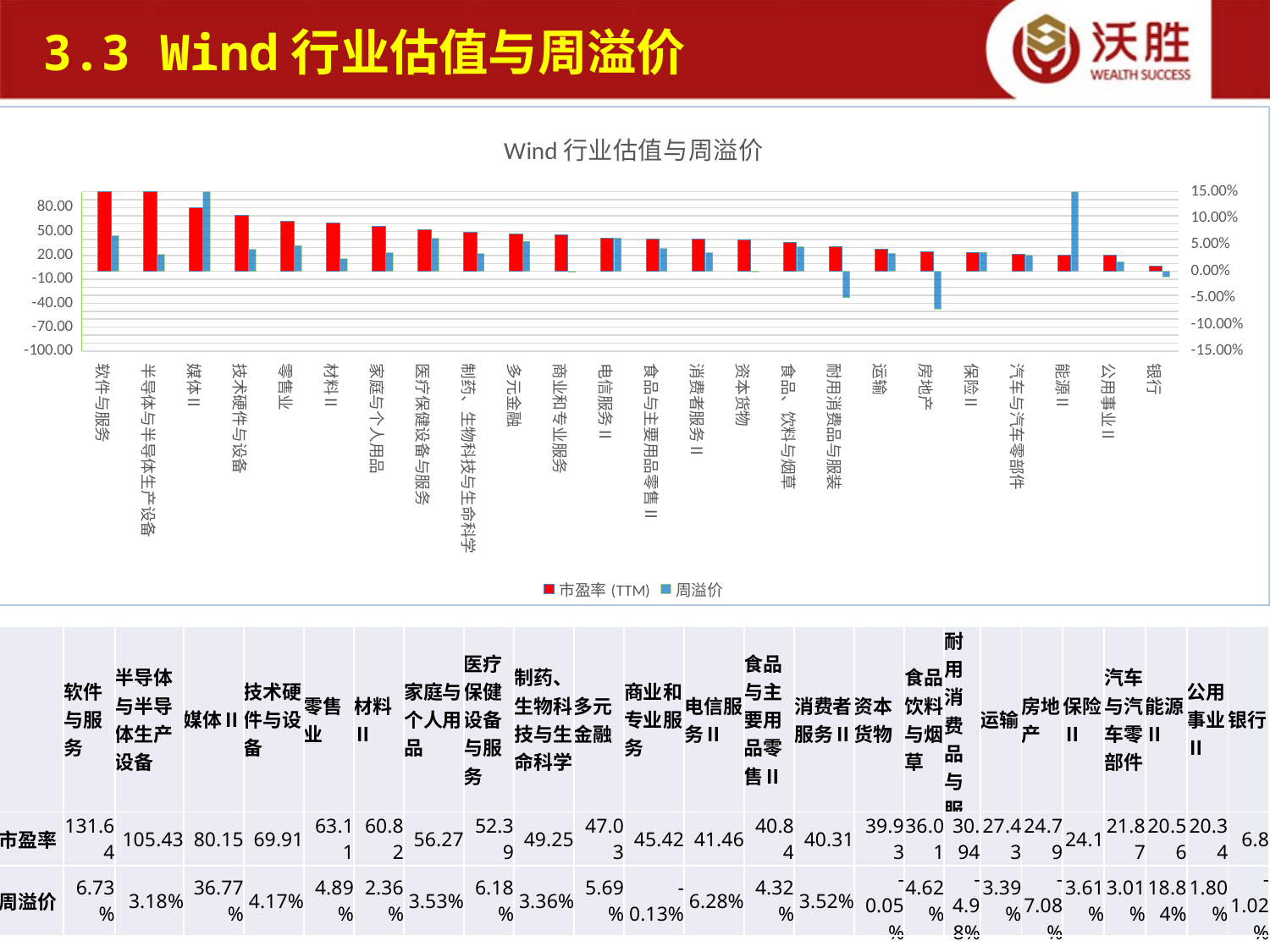
Which industry has the lowest 周溢价? 房地产 What is the 周溢价 value for 电信服务II? 6.28% How many industry categories are plotted on the x axis? 24 Which industry has the highest 市盈率 (TTM)? 软件与服务 How many series does the legend list? 2 What are the two series names shown in the legend? 市盈率 (TTM) and 周溢价 Which has a higher 市盈率 (TTM): 家庭与个人用品 or 制药、生物科技与生命科学? 家庭与个人用品 What is the difference in 市盈率 (TTM) between 媒体II and 技术硬件与设备? 10.24 What is the 市盈率 (TTM) value for 半导体与半导体生产设备? 105.43 What kind of chart is shown on the slide? bar chart Does the 市盈率 (TTM) series generally rise or fall from left to right along the x axis? fall Which industry has the lowest 市盈率 (TTM)? 银行